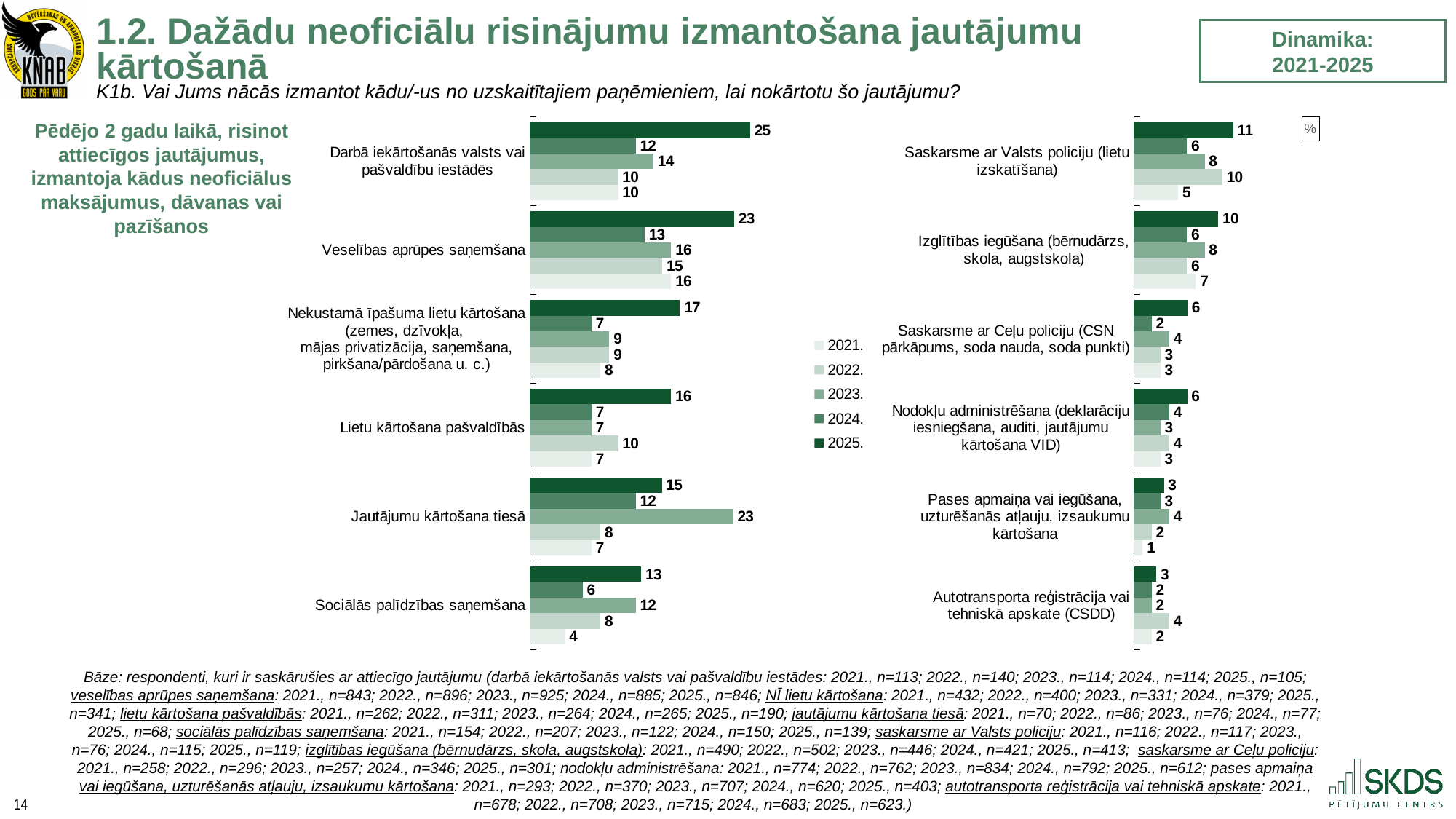
On the right chart, what is the 2022 value for 'Saskarsme ar Valsts policiju (lietu izskatīšana)'? 10 On the left chart, what is the 2023 value for 'Jautājumu kārtošana tiesā'? 23 How many categories are shown on the right chart? 6 On the right chart, what is the difference between the 2025 and 2021 values for 'Saskarsme ar Valsts policiju (lietu izskatīšana)'? 6 On the left chart, which is larger for 'Sociālās palīdzības saņemšana': the 2025 value or the 2023 value? 2025 On the left chart, what is the 2025 value for 'Darbā iekārtošanās valsts vai pašvaldību iestādēs'? 25 On the left chart, what is the difference between the 2025 and 2024 values for 'Veselības aprūpes saņemšana'? 10 How many series does the legend list? 5 On the left chart, which category has the lowest 2021 value? Sociālās palīdzības saņemšana What type of chart is used on this slide? Bar chart On the left chart, which category has the highest 2025 value? Darbā iekārtošanās valsts vai pašvaldību iestādēs On the right chart, what is the 2021 value for 'Pases apmaiņa vai iegūšana, uzturēšanās atļauju, izsaukumu kārtošana'? 1